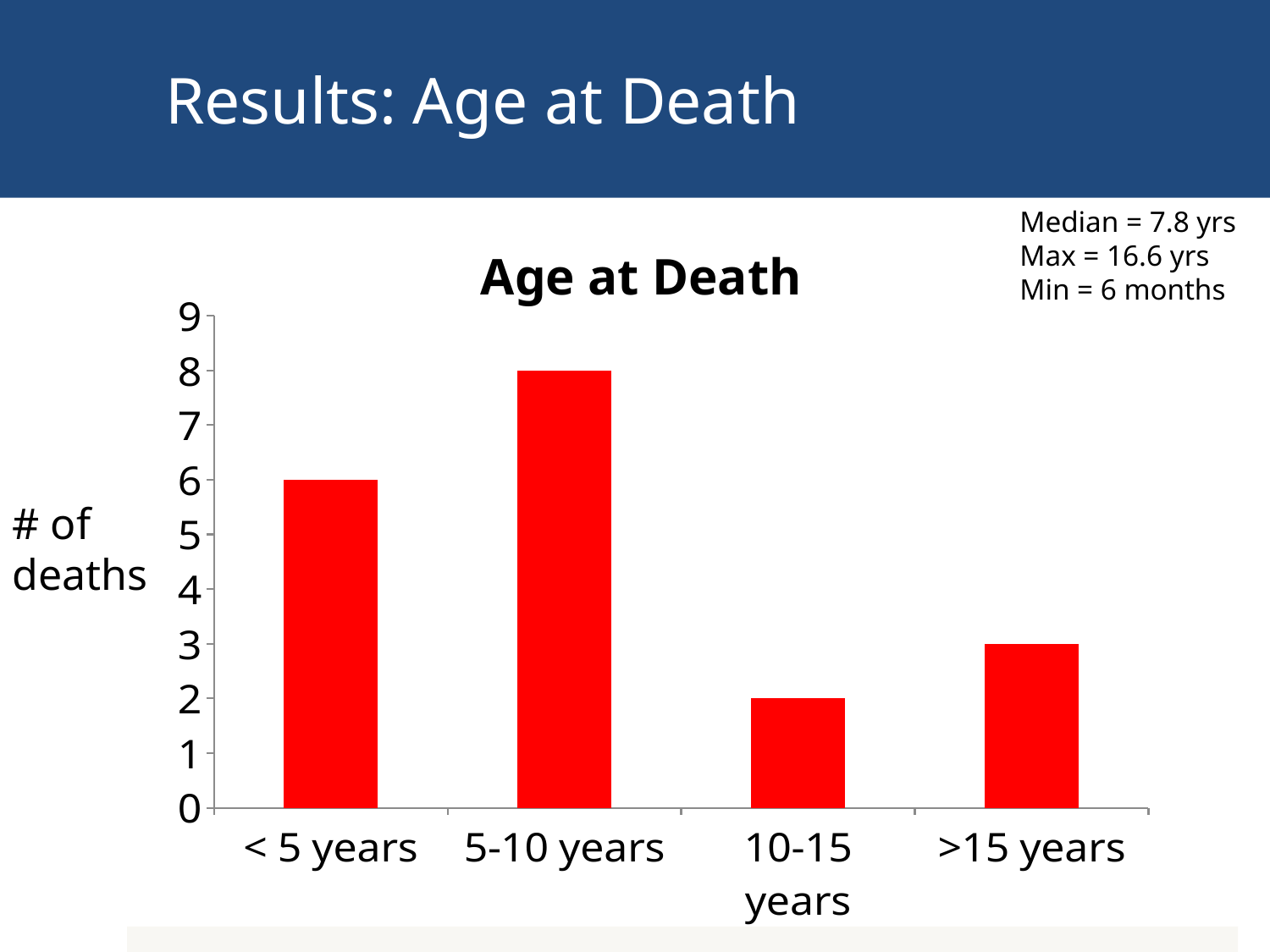
What kind of chart is shown on the slide? Bar chart What is the number of deaths for the 10-15 years category? 2 What is the number of deaths for the 5-10 years category? 8 What is the number of deaths for the < 5 years category? 6 Which age category has the lowest number of deaths? 10-15 years How many age categories are shown on the x axis? 4 What is the title of the chart? Age at Death What is the number of deaths for the >15 years category? 3 What is the total number of deaths across all four age categories? 19 Which has more deaths, the < 5 years category or the >15 years category? < 5 years What is the difference in number of deaths between the 5-10 years and < 5 years categories? 2 Which age category has the highest number of deaths? 5-10 years